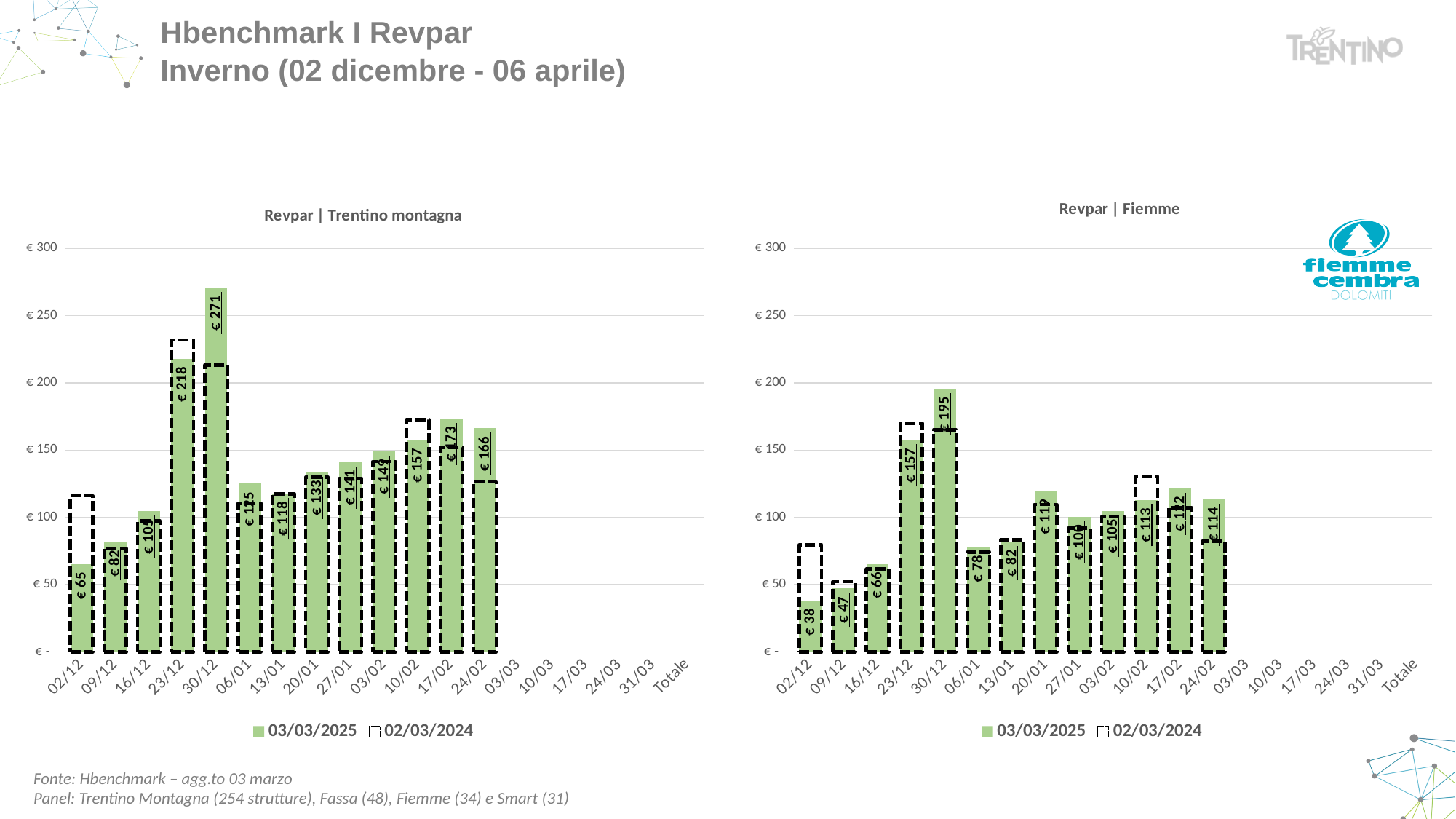
In the 'Revpar | Trentino montagna' chart, is the 02/03/2024 value for 02/12 greater or less than 100? greater How many series does the legend of the 'Revpar | Fiemme' chart list? 2 In the 'Revpar | Trentino montagna' chart, which week has the lowest 03/03/2025 value? 02/12 In the 'Revpar | Fiemme' chart, which is larger for 03/03/2025: the value for 23/12 or the value for 10/02? 23/12 In the 'Revpar | Trentino montagna' chart, what is the difference between the 03/03/2025 values for 30/12 and 23/12? € 53 In the 'Revpar | Trentino montagna' chart, how many weeks have a 03/03/2025 bar plotted? 13 In the 'Revpar | Trentino montagna' chart, what is the 03/03/2025 value for 30/12? € 271 In the 'Revpar | Trentino montagna' chart, which week has the highest 03/03/2025 value? 30/12 In the 'Revpar | Fiemme' chart, which week has the lowest 03/03/2025 value? 02/12 In the 'Revpar | Fiemme' chart, is the 02/03/2024 value for 02/12 greater or less than 50? greater In the 'Revpar | Fiemme' chart, what is the 03/03/2025 value for 30/12? € 195 What type of chart is 'Revpar | Trentino montagna'? bar chart